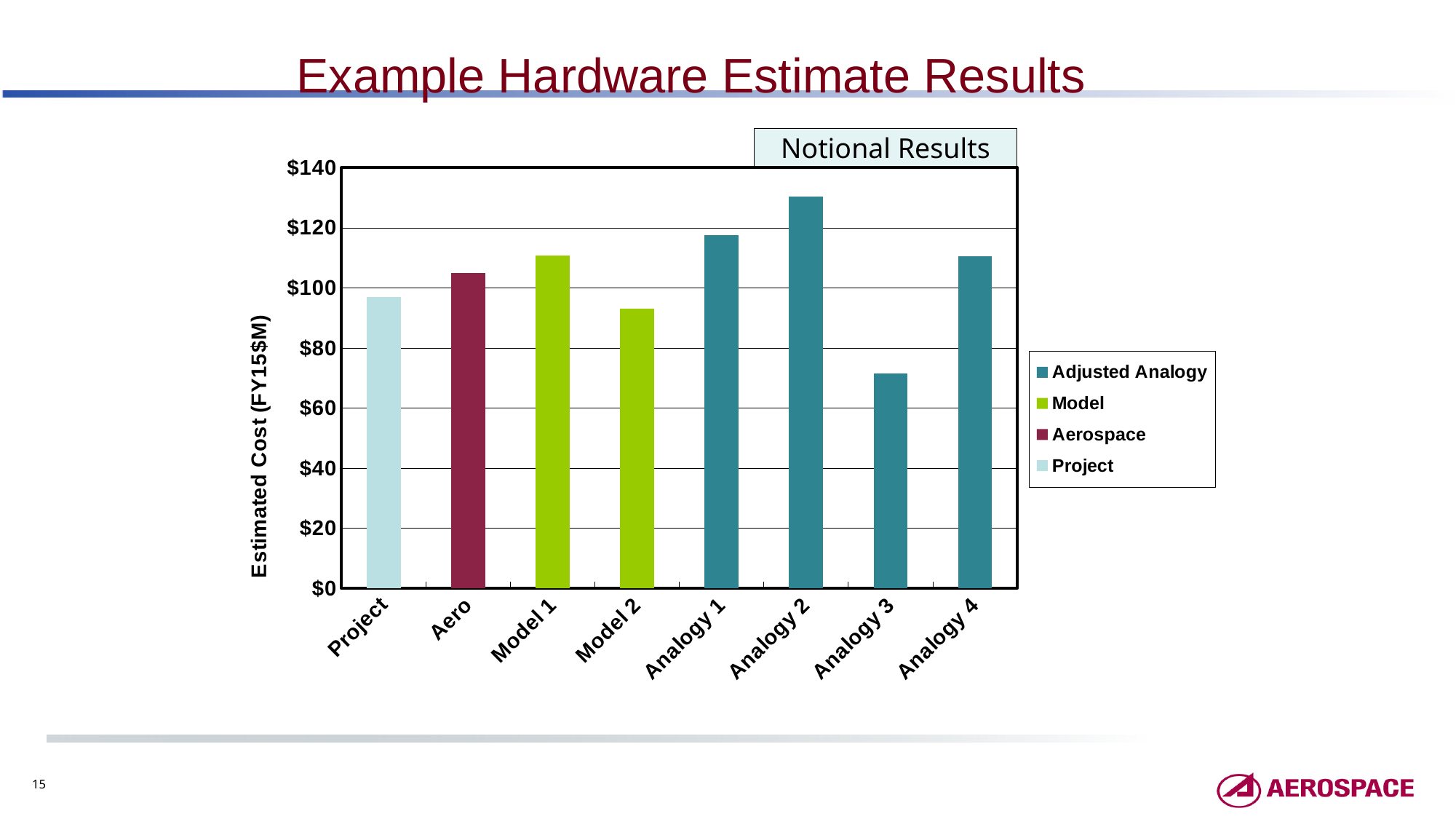
Which is larger, the value for Aero or the value for Project? Aero Which is larger, the value for Model 1 or the value for Model 2? Model 1 Is the value for Analogy 3 greater or less than $80? less What is the label of the y axis? Estimated Cost (FY15$M) How many categories are plotted along the x axis? 8 How many series does the legend list? 4 What kind of chart is shown on the slide? bar chart Which category has the highest estimated cost? Analogy 2 Which category has the lowest estimated cost? Analogy 3 Is the value for Analogy 2 greater or less than $120? greater Is the value for Model 2 greater or less than $100? less